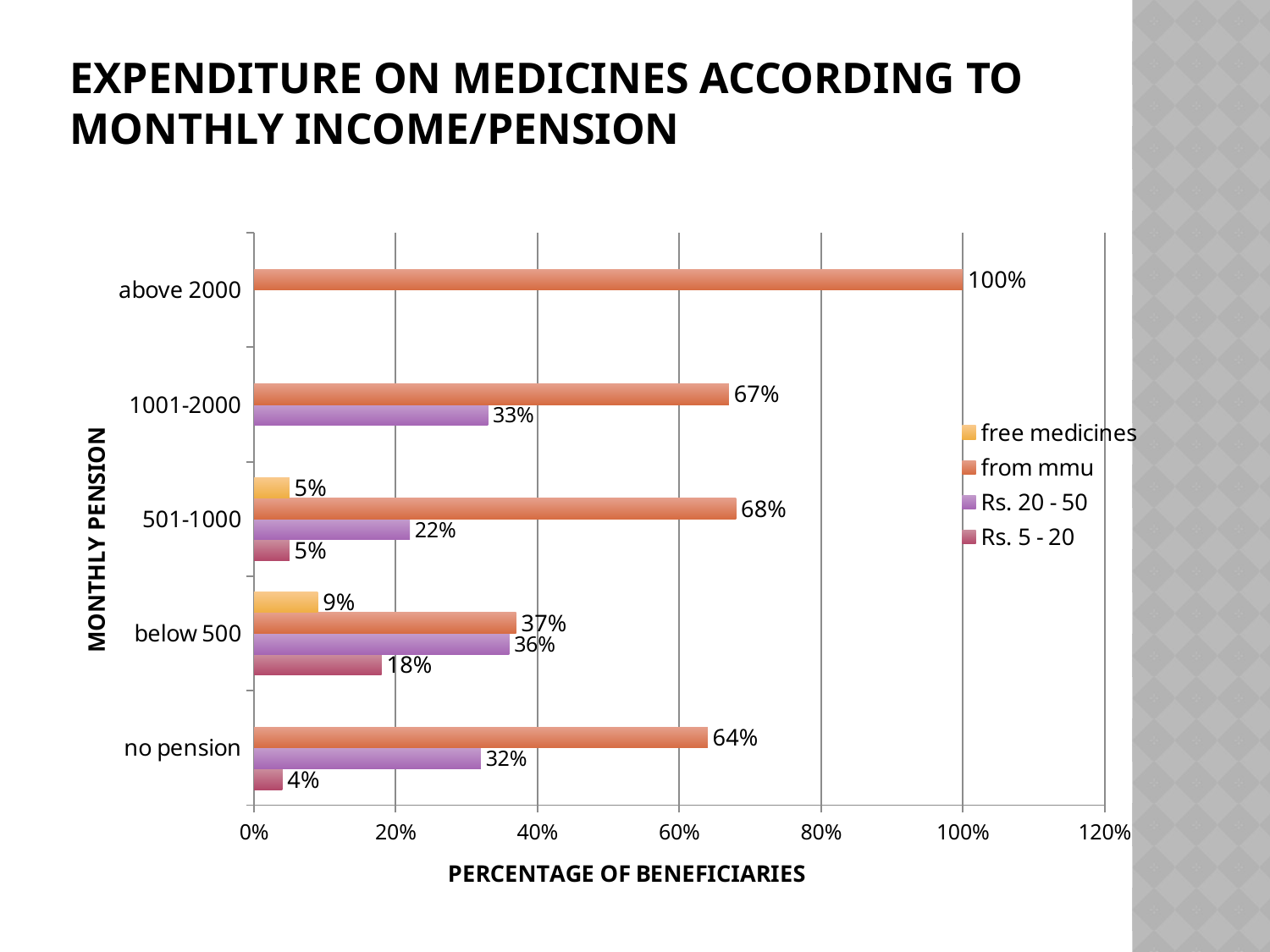
How many series does the legend list? 4 Which category has the highest value for 'from mmu'? above 2000 What is the value for 'Rs. 5 - 20' in the 'no pension' category? 4% What is the value for 'Rs. 20 - 50' in the '1001-2000' category? 33% What is the difference between the 'from mmu' value and the 'Rs. 20 - 50' value in the 'no pension' category? 32% Which category has the lowest value for 'from mmu'? below 500 What kind of chart is shown on the slide? bar chart What is the value for 'free medicines' in the 'below 500' category? 9% What is the title of the x axis? PERCENTAGE OF BENEFICIARIES How many monthly pension categories are shown on the y axis? 5 What is the value for 'from mmu' in the 'above 2000' category? 100% In the '501-1000' category, which is larger: the 'from mmu' value or the 'Rs. 20 - 50' value? from mmu